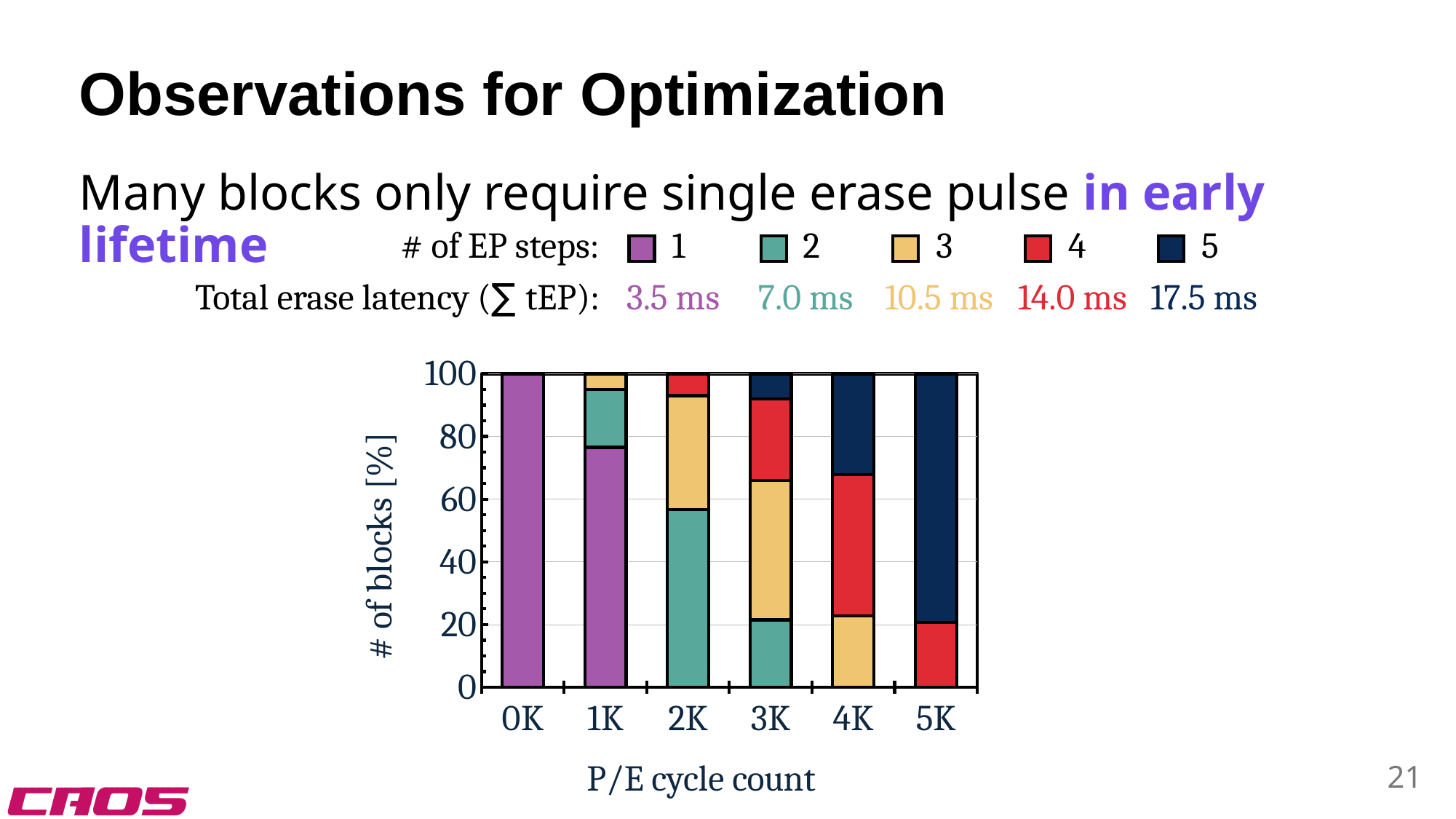
Does the share of blocks requiring only 1 EP step rise or fall as the P/E cycle count increases? fall How many P/E cycle count categories are shown on the x axis? 6 How many series (# of EP steps) does the legend list? 5 Is the share of blocks requiring 4 EP steps at 5K P/E cycles greater or less than 40? less What is the label of the y axis? # of blocks [%] Is the share of blocks requiring 5 EP steps at 5K P/E cycles greater or less than 60? greater Is the share of blocks requiring 2 EP steps at 2K P/E cycles greater or less than 40? greater What percentage of blocks at 0K P/E cycles require 1 EP step? 100 According to the legend, what is the total erase latency for 3 EP steps? 10.5 ms What is the total height of the stacked bar at 3K P/E cycles? 100 What kind of chart is shown on the slide? stacked bar chart